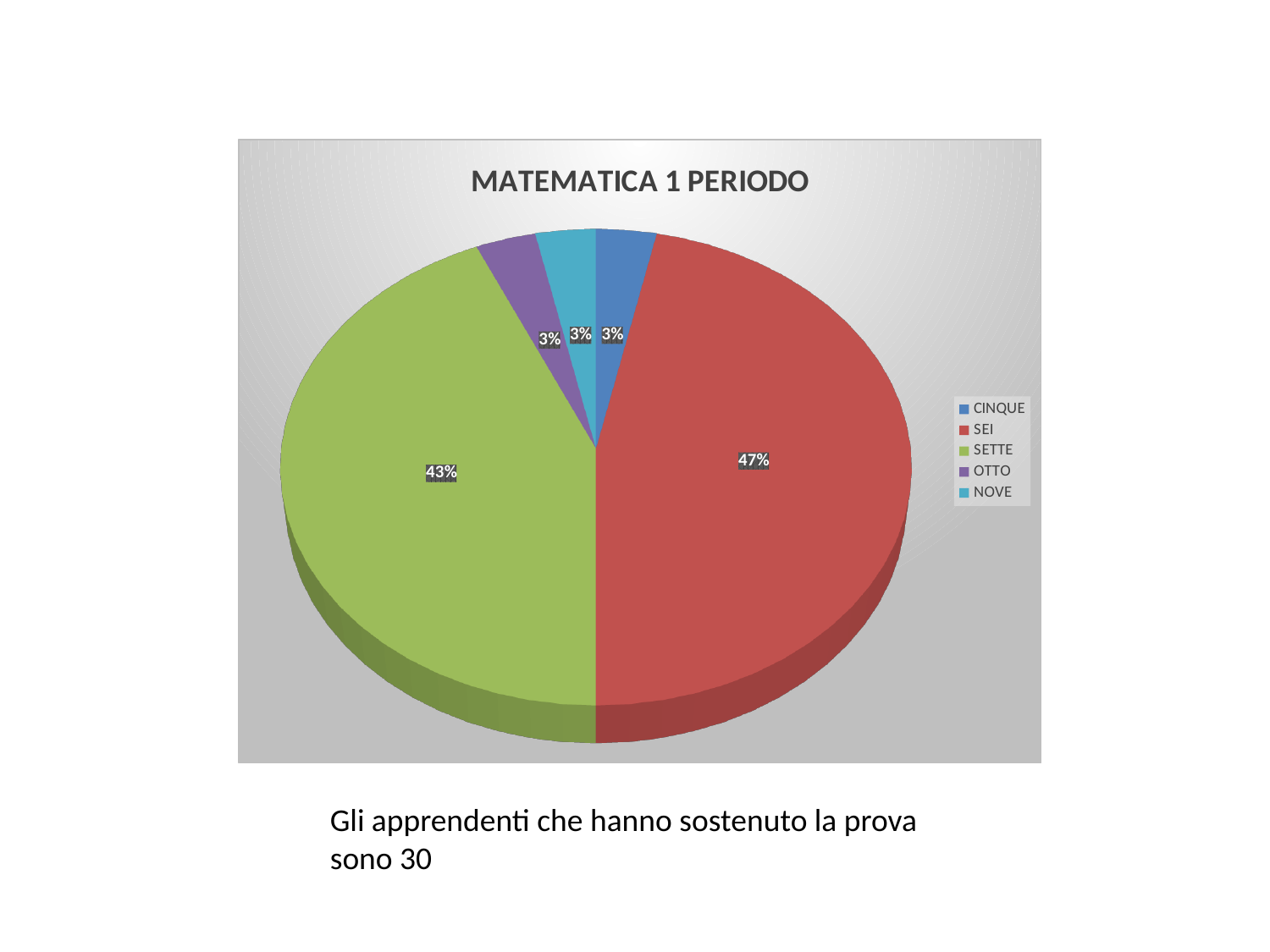
What percentage of the pie does the NOVE slice represent? 3% How many entries are listed in the chart legend? 5 Which category has the largest slice of the pie? SEI What type of chart is shown on the slide? pie chart Which slice is larger, SEI or SETTE? SEI What percentage of the pie does the SETTE slice represent? 43% What percentage of the pie does the SEI slice represent? 47% What is the title of the chart? MATEMATICA 1 PERIODO What percentage of the pie does the OTTO slice represent? 3% What is the difference in percentage points between the SEI slice and the SETTE slice? 4 What percentage of the pie does the CINQUE slice represent? 3% How many slices does the pie chart have? 5